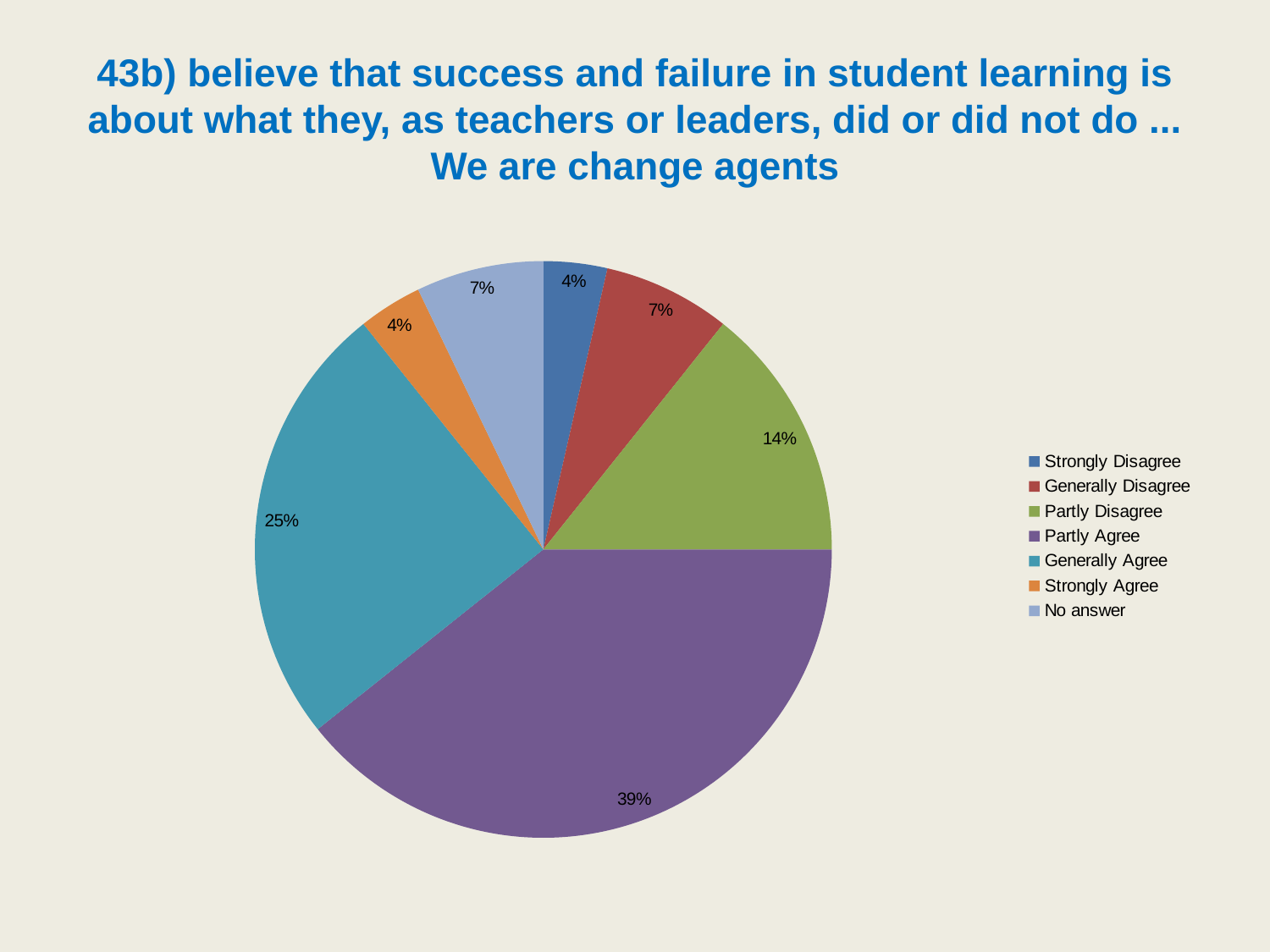
What percentage of respondents gave No answer? 7% Which response category has the largest share of the pie? Partly Agree What is the combined share of Partly Agree and Generally Agree? 64% How many response categories are shown in the pie chart? 7 What percentage of respondents chose Generally Agree? 25% What percentage of respondents chose Partly Agree? 39% What is the difference in percentage points between Partly Agree and Generally Agree? 14 What percentage of respondents chose Partly Disagree? 14% Which colour represents Partly Agree in the legend? Purple What percentage of respondents chose Strongly Agree? 4% What kind of chart is shown on the slide? Pie chart Which is larger, the share for Generally Disagree or the share for Partly Disagree? Partly Disagree